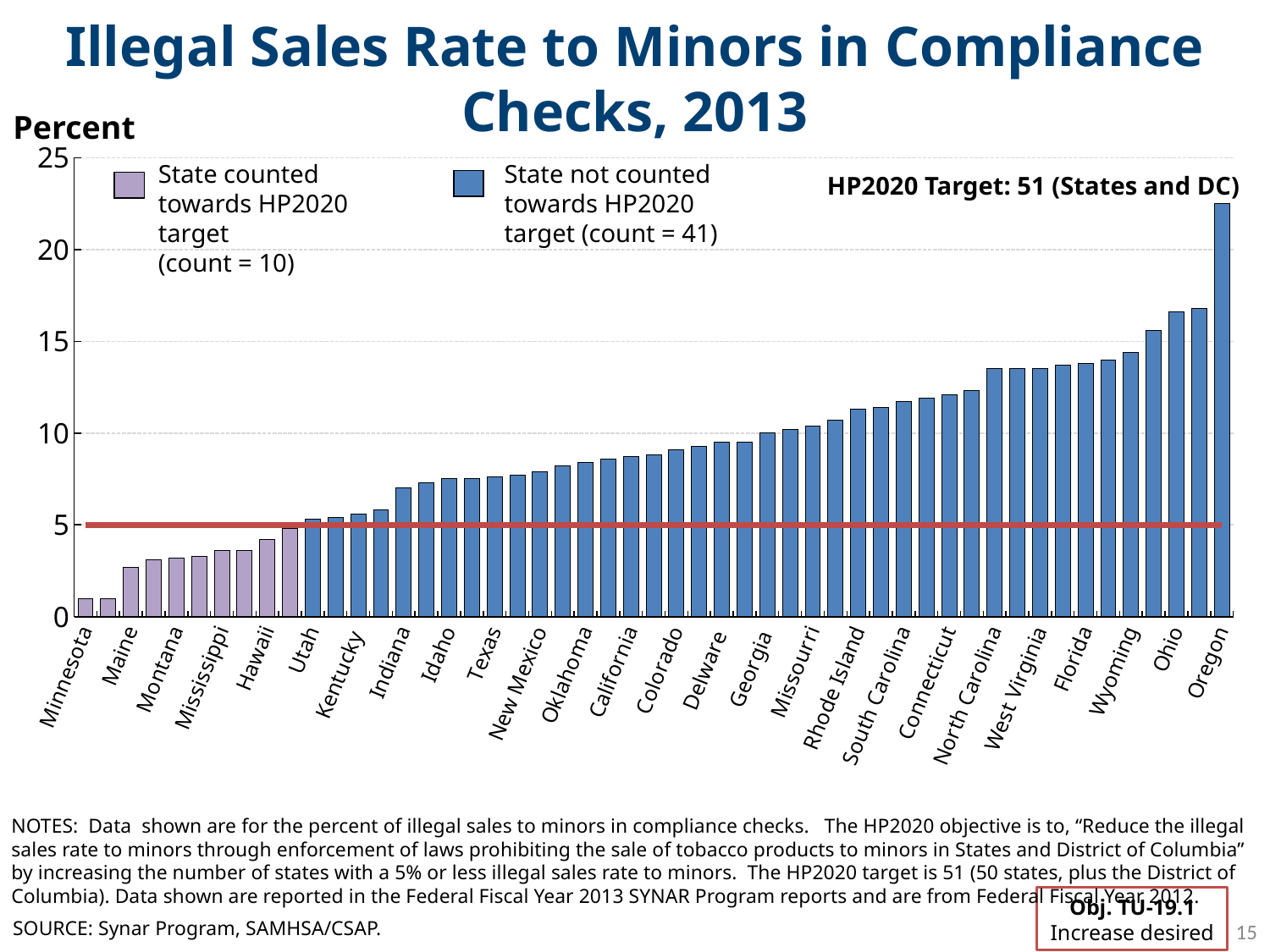
Which state has the highest illegal sales rate to minors in the chart? Oregon Is the value for Oregon greater or less than 20? greater Is the value for Ohio greater or less than 15? greater Which is larger, the value for Oregon or the value for Ohio? Oregon Is the value for Florida greater or less than 10? greater According to the legend, how many states are counted towards the HP2020 target? 10 Do the bar values rise or fall from left to right along the x axis? rise How many series does the legend list? 2 What kind of chart is shown on the slide? bar chart Which is larger, the value for Texas or the value for Florida? Florida